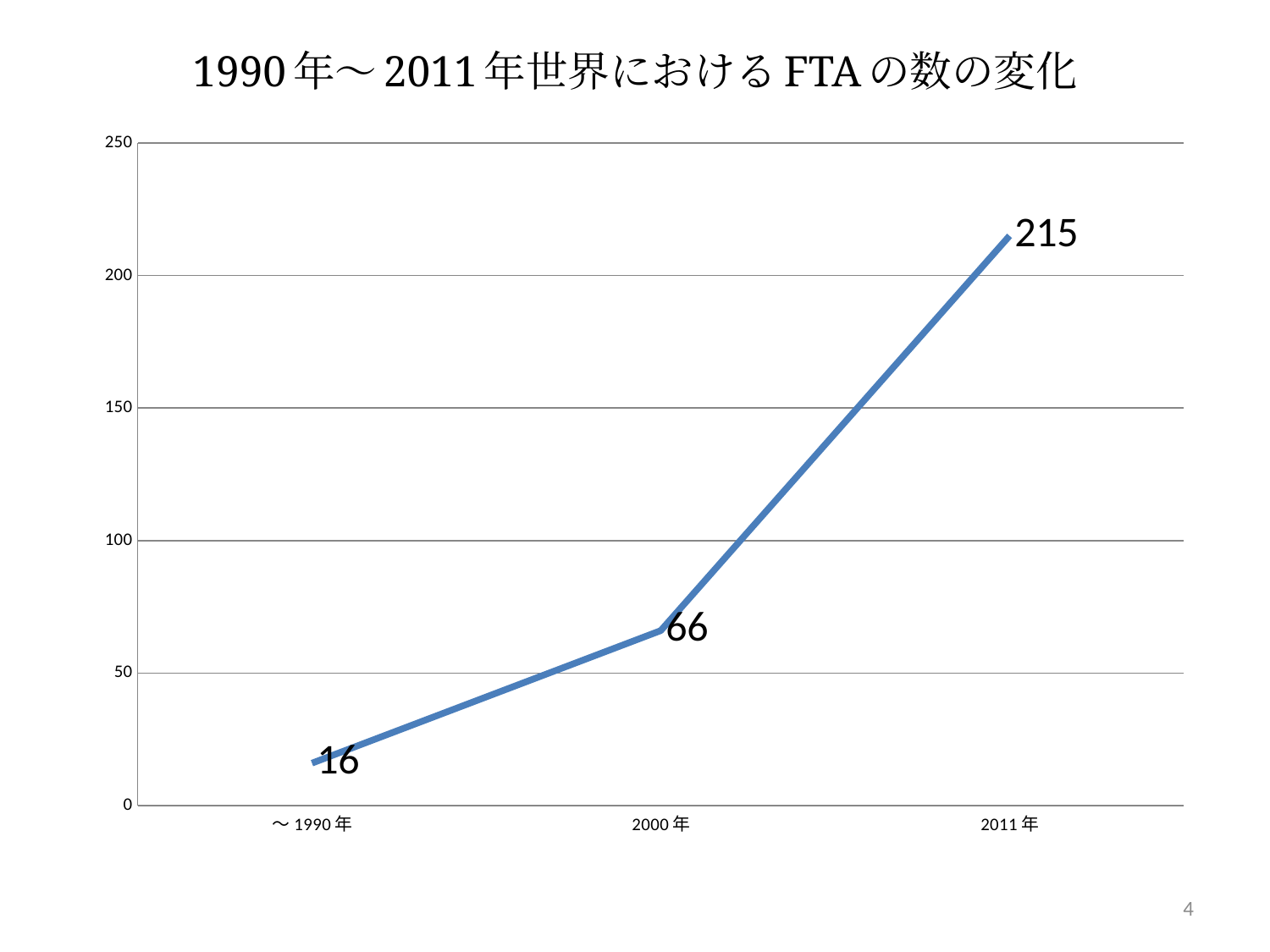
What is the difference between the values for 2011年 and 2000年? 149 Which category has the lowest value? ～1990年 What is the value for 2011年? 215 What is the value for ～1990年? 16 Is the value for 2011年 greater or less than 200? greater Which category has the highest value? 2011年 How many data points are plotted on the chart? 3 Which is larger, the value for 2000年 or the value for ～1990年? 2000年 What is the difference between the values for 2000年 and ～1990年? 50 Do the values rise or fall along the x axis? rise What kind of chart is shown on the slide? line chart What is the value for 2000年? 66